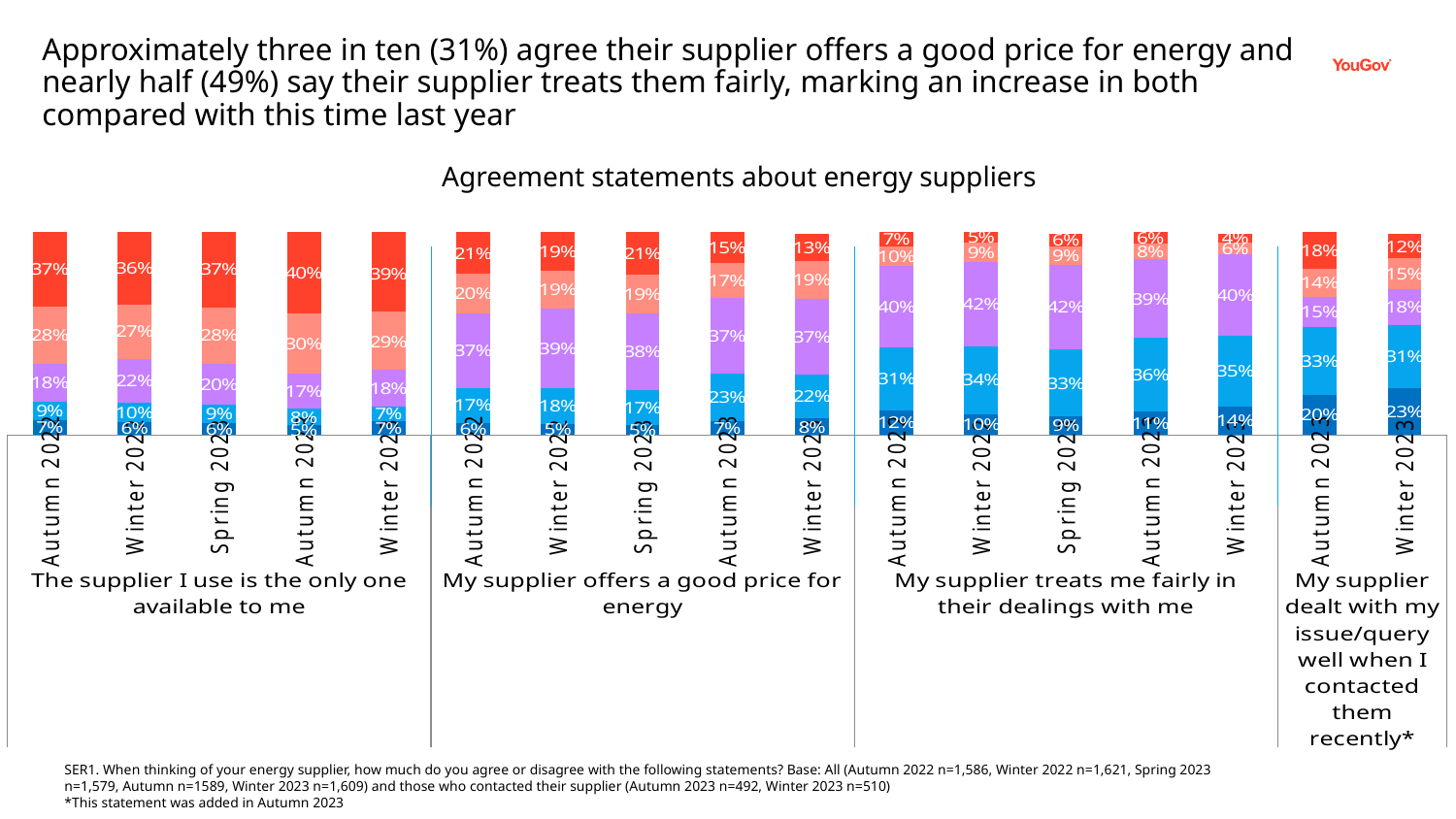
For the statement 'The supplier I use is the only one available to me', what is the value of the top (red) segment for Autumn 2023? 40% How many statement groups are shown along the x axis of the chart? 4 For the statement 'The supplier I use is the only one available to me', which wave has the lowest value for the top (red) segment? Winter 2022 For the statement 'My supplier dealt with my issue/query well when I contacted them recently*', what is the value of the largest (light blue) segment for Autumn 2023? 33% For the statement 'My supplier treats me fairly in their dealings with me', what is the difference between the bottom (dark blue) segment in Winter 2023 (14%) and Autumn 2022 (12%)? 2 percentage points What is the title of the chart? Agreement statements about energy suppliers For the statement 'My supplier offers a good price for energy', what is the value of the top (red) segment for Winter 2023? 13% For the statement 'My supplier offers a good price for energy', is the top (red) segment larger in Autumn 2022 or Winter 2023? Autumn 2022 What kind of chart is shown on the slide? Stacked bar chart For the statement 'My supplier treats me fairly in their dealings with me', what is the value of the bottom (dark blue) segment for Winter 2023? 14% How many bars are shown for the statement 'My supplier dealt with my issue/query well when I contacted them recently*'? 2 For the statement 'The supplier I use is the only one available to me', which wave has the highest value for the top (red) segment? Autumn 2023